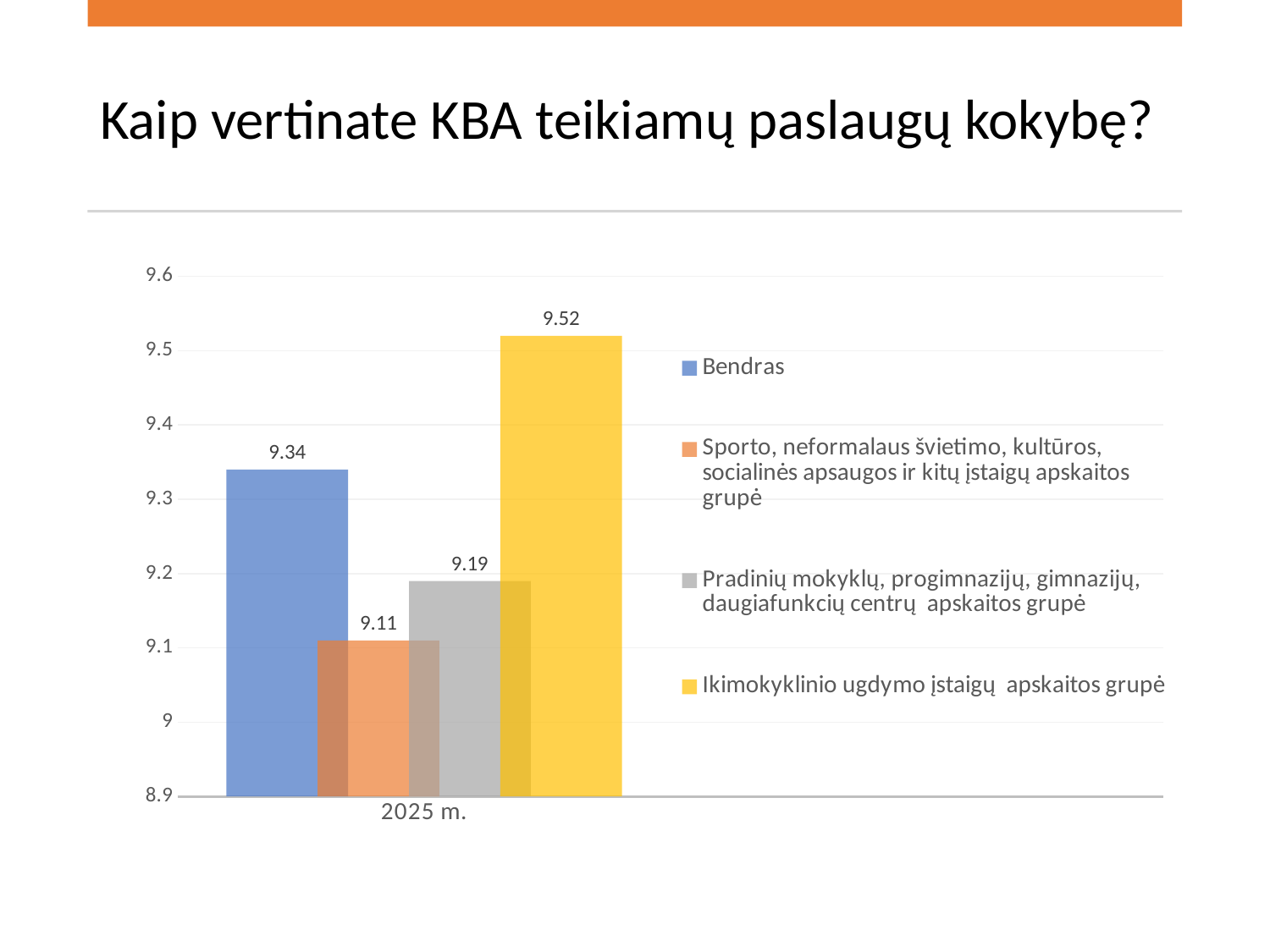
What is the category label on the x axis? 2025 m. Which is larger: the value for Bendras or the value for Pradinių mokyklų, progimnazijų, gimnazijų, daugiafunkcių centrų apskaitos grupė? Bendras Which series has the lowest value? Sporto, neformalaus švietimo, kultūros, socialinės apsaugos ir kitų įstaigų apskaitos grupė What is the value for Bendras in 2025 m.? 9.34 Is the value for Ikimokyklinio ugdymo įstaigų apskaitos grupė greater or less than 9.5? greater What is the value for Sporto, neformalaus švietimo, kultūros, socialinės apsaugos ir kitų įstaigų apskaitos grupė? 9.11 How many series does the legend list? 4 Which series has the highest value? Ikimokyklinio ugdymo įstaigų apskaitos grupė What kind of chart is shown on the slide? Bar chart What is the value for Ikimokyklinio ugdymo įstaigų apskaitos grupė in 2025 m.? 9.52 What is the difference between the Ikimokyklinio ugdymo įstaigų apskaitos grupė value and the Bendras value? 0.18 What is the value for Pradinių mokyklų, progimnazijų, gimnazijų, daugiafunkcių centrų apskaitos grupė? 9.19